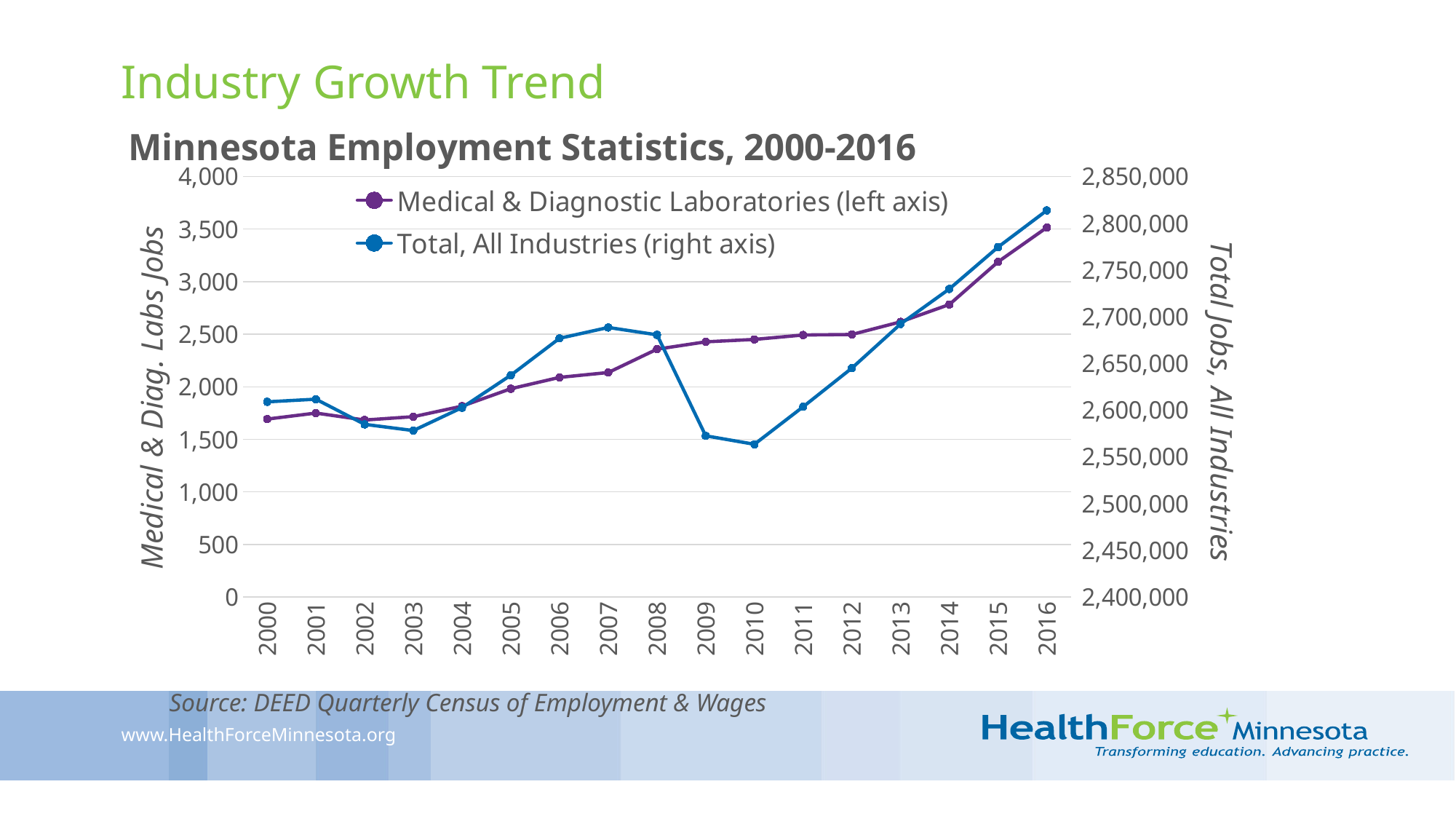
Is the value for Total, All Industries in 2010 greater or less than 2,600,000? less Does the Medical & Diagnostic Laboratories line generally rise or fall from 2000 to 2016? Rise What is the title of the chart? Minnesota Employment Statistics, 2000-2016 Is the value for Medical & Diagnostic Laboratories in 2000 greater or less than 2,000? less How many years are plotted along the x axis? 17 Is the value for Medical & Diagnostic Laboratories in 2016 greater or less than 3,000? greater What kind of chart is shown on the slide? Line chart Which year has the highest value for Medical & Diagnostic Laboratories? 2016 Which year has the highest value for Total, All Industries? 2016 How many series does the legend list? 2 Which year has the lowest value for Total, All Industries? 2010